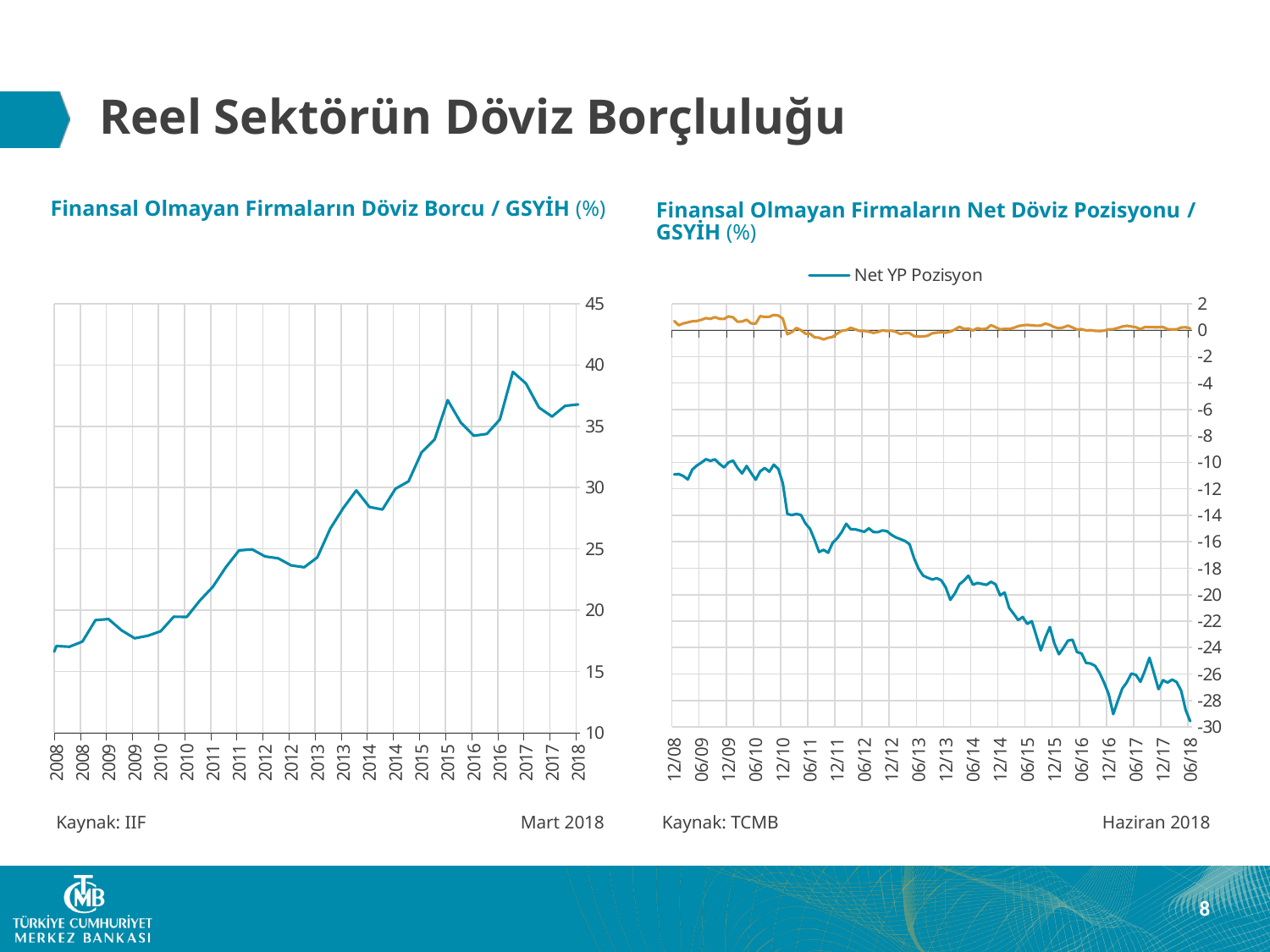
In the right chart, 'Finansal Olmayan Firmaların Net Döviz Pozisyonu / GSYİH', is the blue line's value at 06/18 greater or less than -25? less What is the source given for the right chart, 'Finansal Olmayan Firmaların Net Döviz Pozisyonu / GSYİH'? TCMB In the right chart, 'Finansal Olmayan Firmaların Net Döviz Pozisyonu / GSYİH', at which date does the blue line reach its lowest point? 06/18 In the right chart, 'Finansal Olmayan Firmaların Net Döviz Pozisyonu / GSYİH', does the blue line generally rise or fall from 12/08 to 06/18? Fall What kind of chart is the left chart, 'Finansal Olmayan Firmaların Döviz Borcu / GSYİH (%)'? Line chart In the left chart, 'Finansal Olmayan Firmaların Döviz Borcu / GSYİH', is the value at the end of the series in 2018 greater or less than 35? greater In the left chart, 'Finansal Olmayan Firmaların Döviz Borcu / GSYİH', in which year does the line reach its highest point? 2016 In the left chart, 'Finansal Olmayan Firmaların Döviz Borcu / GSYİH', do the values generally rise or fall from 2008 to 2018? Rise In the right chart, 'Finansal Olmayan Firmaların Net Döviz Pozisyonu / GSYİH', is the blue line's value at 12/08 greater or less than -15? greater In the left chart, 'Finansal Olmayan Firmaların Döviz Borcu / GSYİH', which is larger: the value in 2008 or the value in 2018? 2018 What kind of chart is the right chart, 'Finansal Olmayan Firmaların Net Döviz Pozisyonu / GSYİH (%)'? Line chart